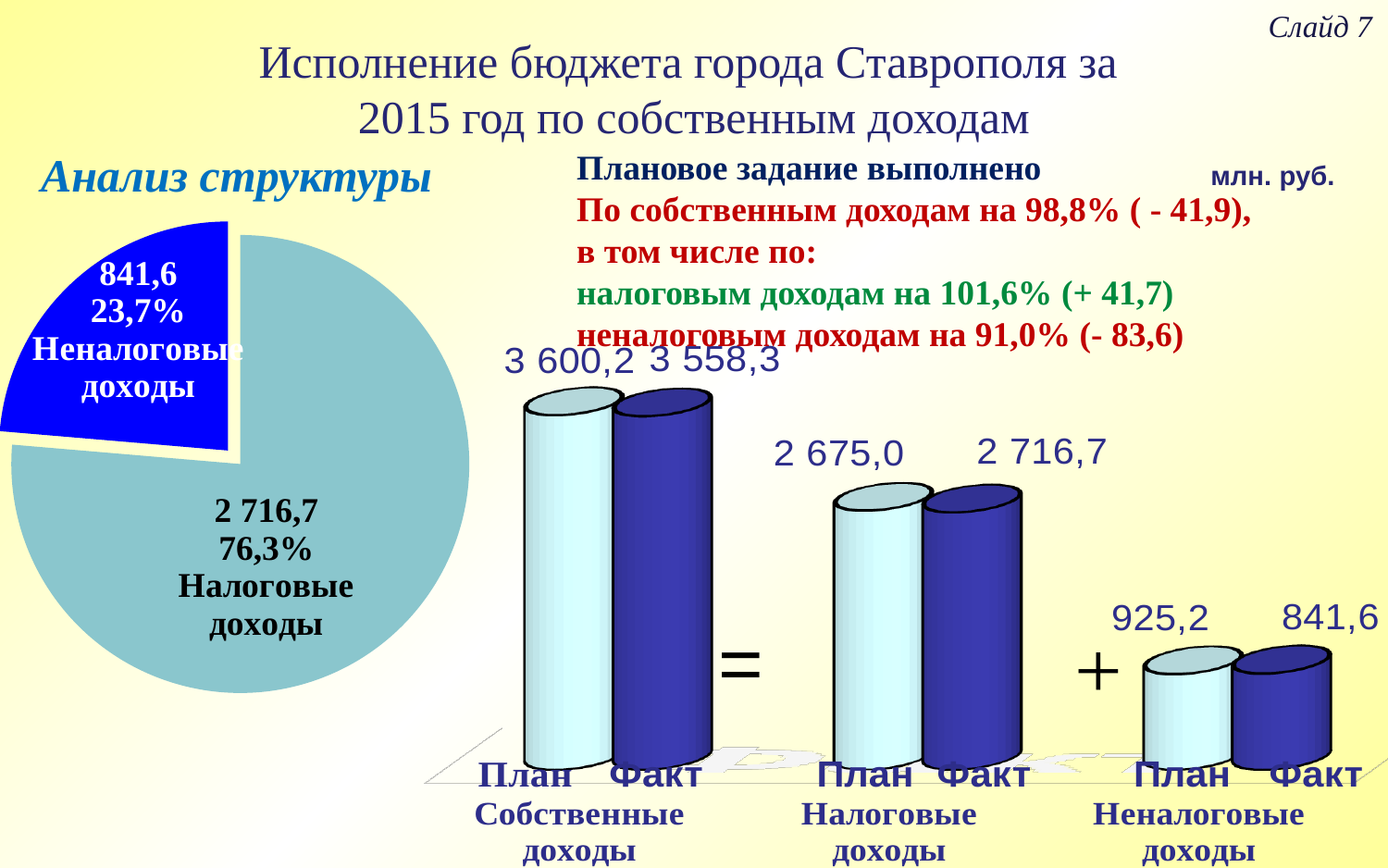
In the pie chart on the left, how many slices are there? 2 In the bar chart on the right, what is the Факт value for Налоговые доходы? 2 716,7 In the bar chart on the right, what is the Факт value for Неналоговые доходы? 841,6 In the bar chart on the right, what is the difference between Факт and План for Налоговые доходы? 41,7 What kind of chart is shown on the right side of the slide? Bar chart In the pie chart on the left, what share of the pie is Налоговые доходы? 76,3% In the pie chart on the left, which slice is larger, Налоговые доходы or Неналоговые доходы? Налоговые доходы In the pie chart on the left, what is the value for Неналоговые доходы? 841,6 In the bar chart on the right, what is the difference between План and Факт for Неналоговые доходы? 83,6 In the bar chart on the right, which is larger for Собственные доходы, План or Факт? План In the bar chart on the right, what is the План value for Собственные доходы? 3 600,2 In the bar chart on the right, which category has the lowest Факт value? Неналоговые доходы